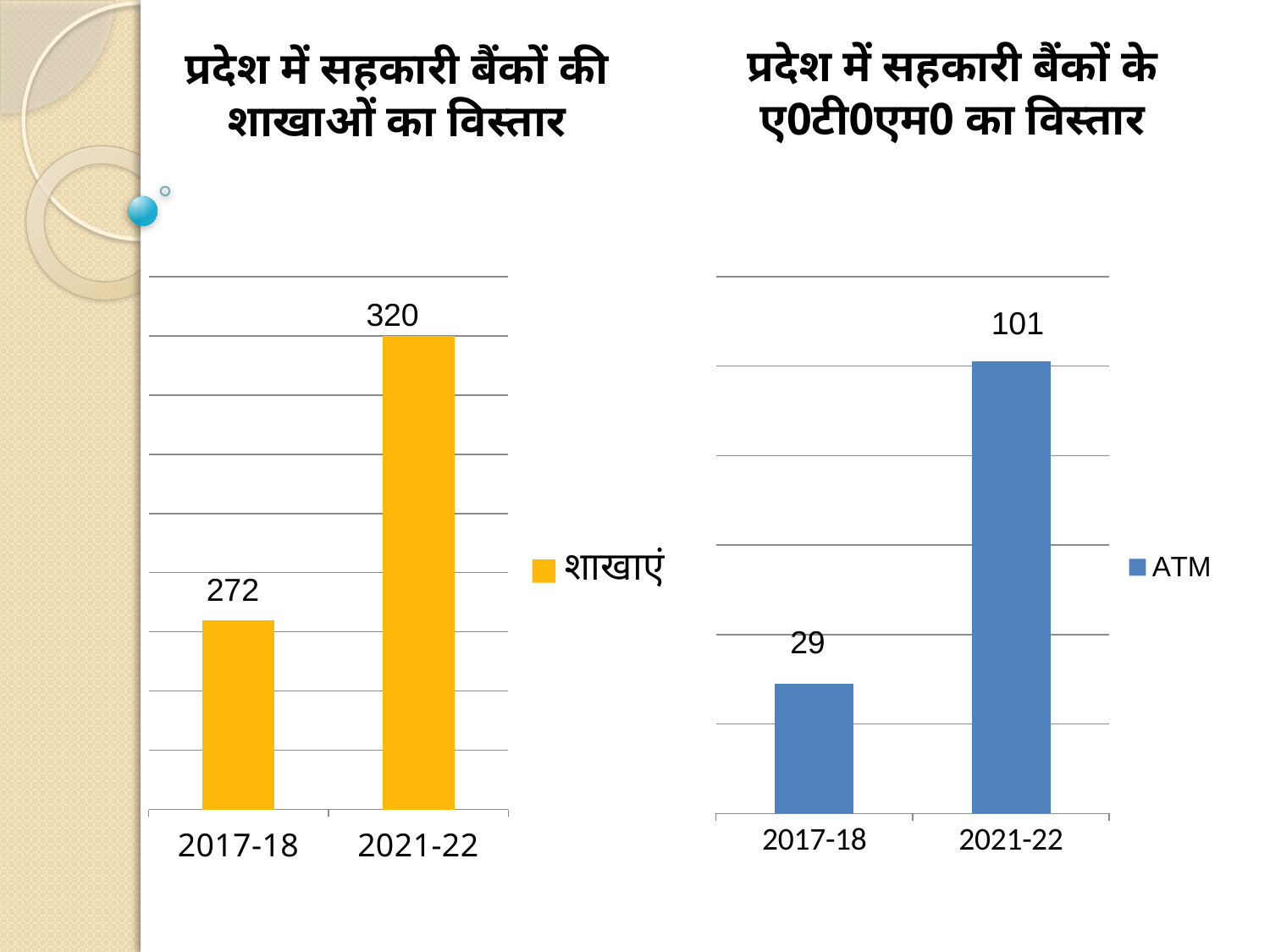
What is the legend entry of the right chart? ATM In the left chart, do the values rise or fall from 2017-18 to 2021-22? rise In the left chart (branches of cooperative banks), what is the value for 2017-18? 272 In the right chart, what is the difference between the ATM values for 2021-22 and 2017-18? 72 In the left chart (branches of cooperative banks), what is the value for 2021-22? 320 How many categories are shown on the x axis of the right chart? 2 In the left chart, by how much did the number of branches increase from 2017-18 to 2021-22? 48 What type of chart is the left chart? bar chart In the left chart, which year has the lower value? 2017-18 In the right chart (ATMs of cooperative banks), what is the value for 2021-22? 101 In the right chart (ATMs of cooperative banks), what is the value for 2017-18? 29 In the right chart, which year has the higher ATM value? 2021-22